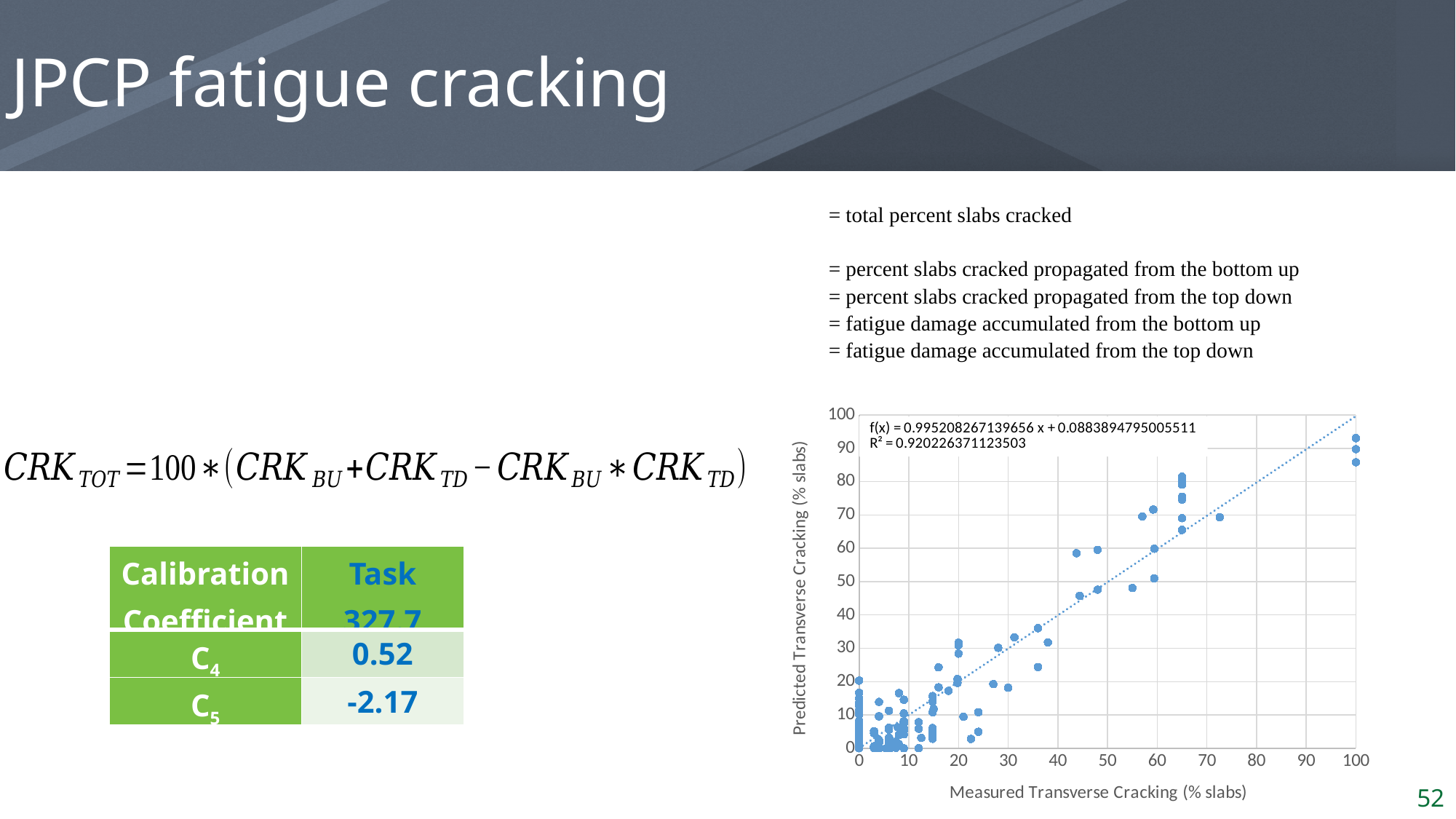
What is the title of the x axis of the scatter chart? Measured Transverse Cracking (% slabs) What kind of chart is shown on the slide? scatter chart Do the predicted values generally rise or fall as measured transverse cracking increases along the x axis? rise What is the trendline equation printed on the scatter chart? f(x) = 0.995208267139656 x + 0.0883894795005511 What is the highest tick value shown on the y axis of the scatter chart? 100 What is the highest tick value shown on the x axis of the scatter chart? 100 What is the slope of the trendline shown on the scatter chart? 0.995208267139656 Are the predicted values for the points at a measured cracking of 100 greater or less than 80? greater What is the title of the y axis of the scatter chart? Predicted Transverse Cracking (% slabs) What is the R² value printed on the scatter chart? 0.920226371123503